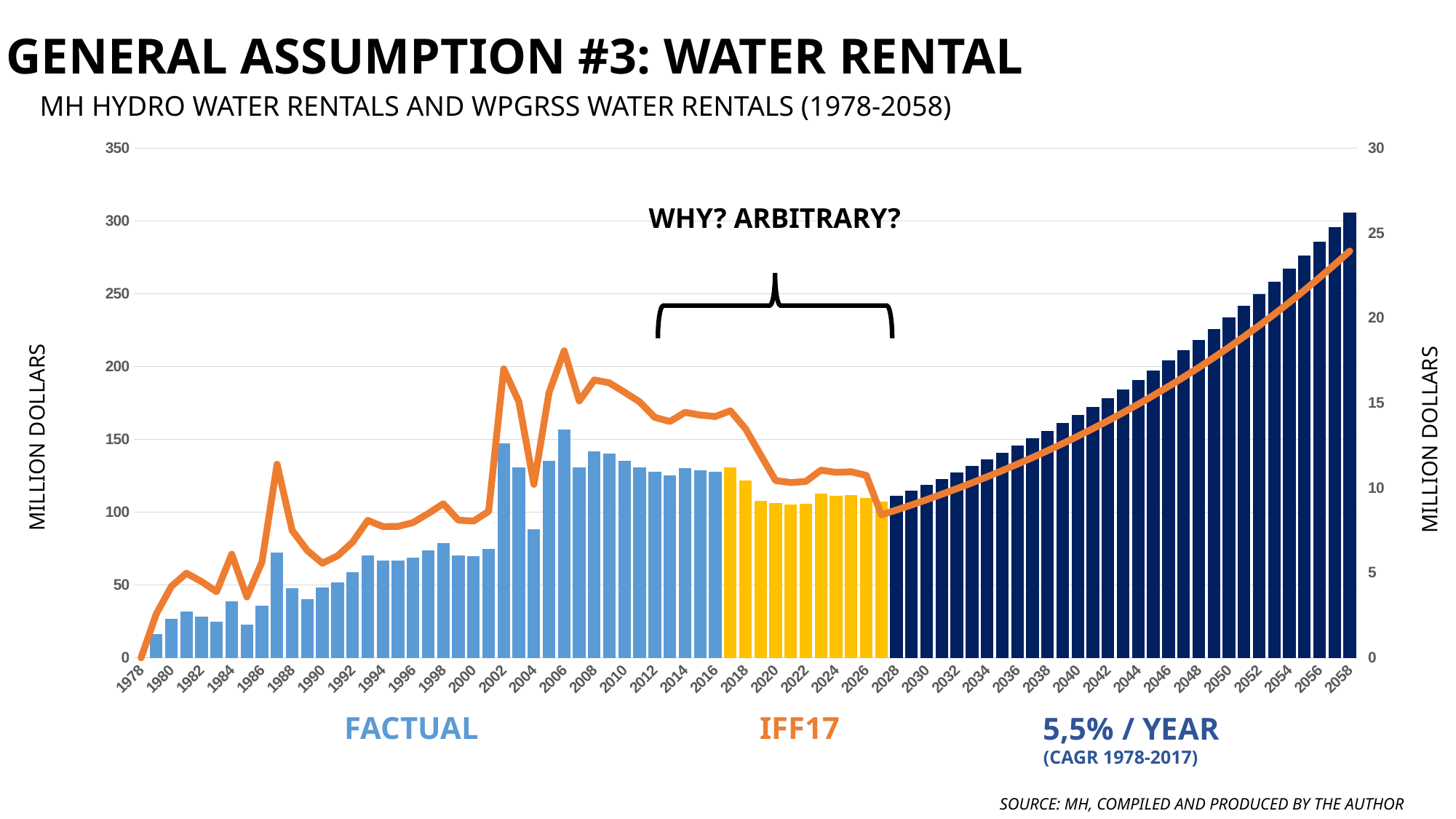
What kind of chart is shown on the slide? A bar chart with a line overlaid Is the bar for 1987 greater or less than 50 on the left axis? greater Which bar is taller, 2028 or 2058? 2058 Do the dark blue bars rise or fall from 2028 to 2058? Rise What label is shown beneath the yellow bars? IFF17 What is the title of the chart? MH HYDRO WATER RENTALS AND WPGRSS WATER RENTALS (1978-2058) Is the bar for 2002 greater or less than 100 on the left axis? greater Which year has the tallest bar in the chart? 2058 Which bar is taller, 2002 or 2004? 2002 Does the orange line rise or fall from 2017 to 2028? Fall Is the bar for 2004 greater or less than 100 on the left axis? less